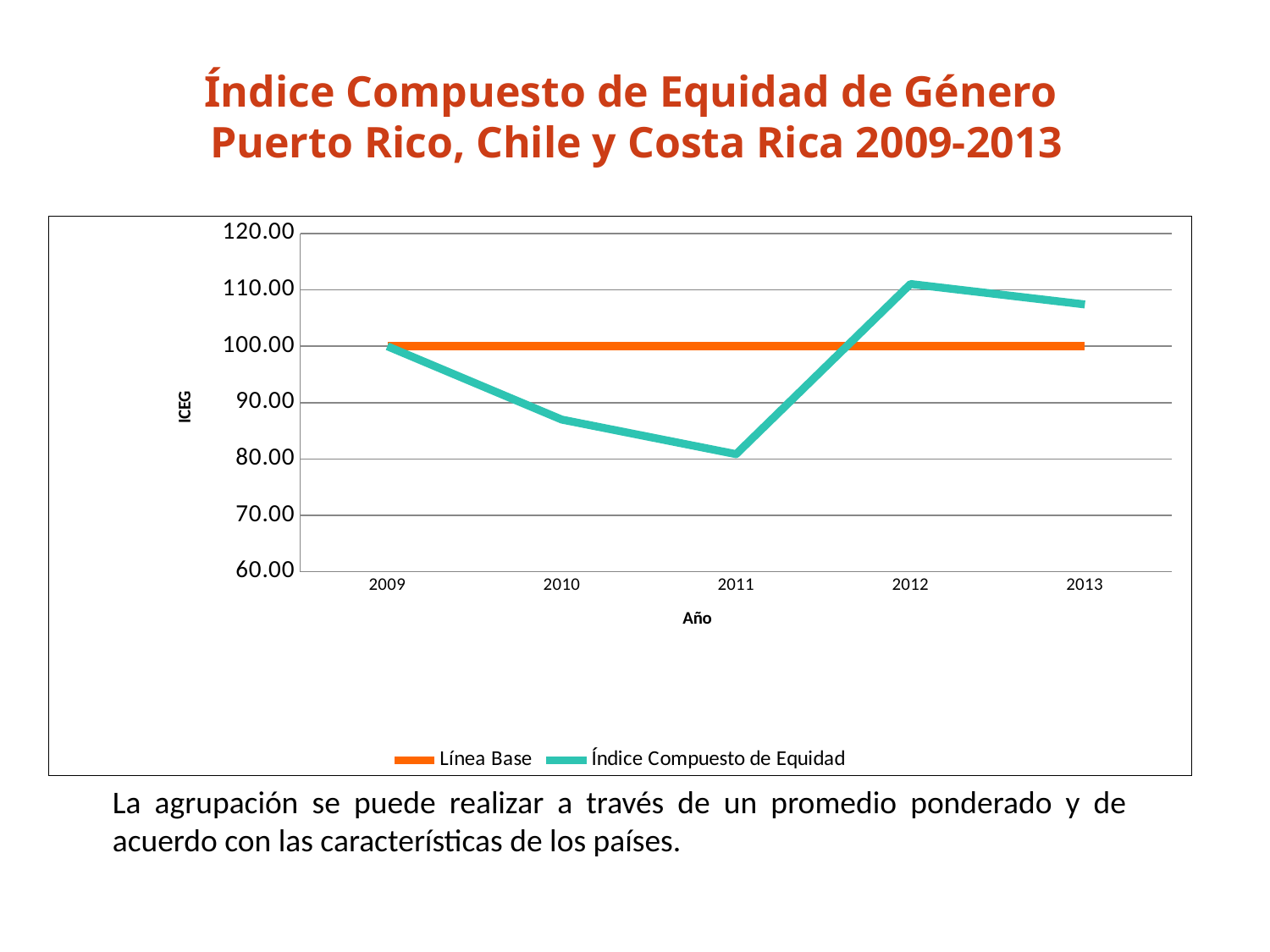
At what value does the Línea Base series sit across all years? 100.00 Is the Índice Compuesto de Equidad value for 2013 greater or less than 100.00? greater How many years are plotted along the x axis? 5 In which year is the Índice Compuesto de Equidad highest? 2012 Is the Índice Compuesto de Equidad value for 2010 greater or less than 90.00? less In which year is the Índice Compuesto de Equidad lowest? 2011 Which is larger, the Índice Compuesto de Equidad value for 2010 or for 2011? 2010 What is the title of the x axis? Año How many series does the legend list? 2 Does the Índice Compuesto de Equidad rise or fall from 2009 to 2011? fall What kind of chart is shown on the slide? line chart